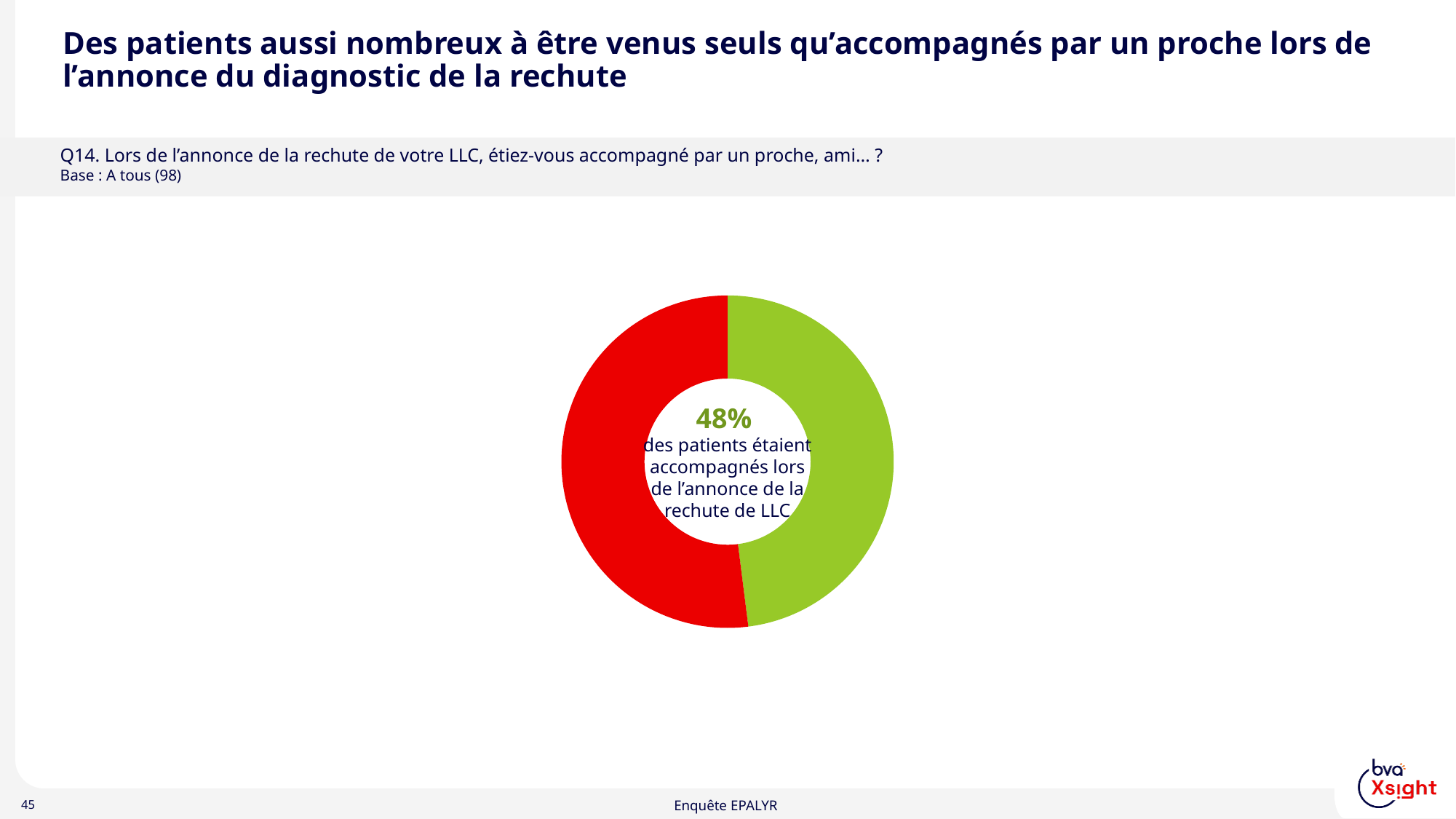
What is the base (number of respondents) for the chart? 98 What percentage of patients were accompanied by a relative or friend when the relapse of their LLC was announced? 48% What kind of chart is shown on the slide? pie chart (donut) Is the share of patients who were accompanied greater or less than 50%? less Which slice of the donut chart is larger, the red one or the green one? the red one What colour is the slice representing the 48% of patients who were accompanied? green How many slices does the donut chart have? 2